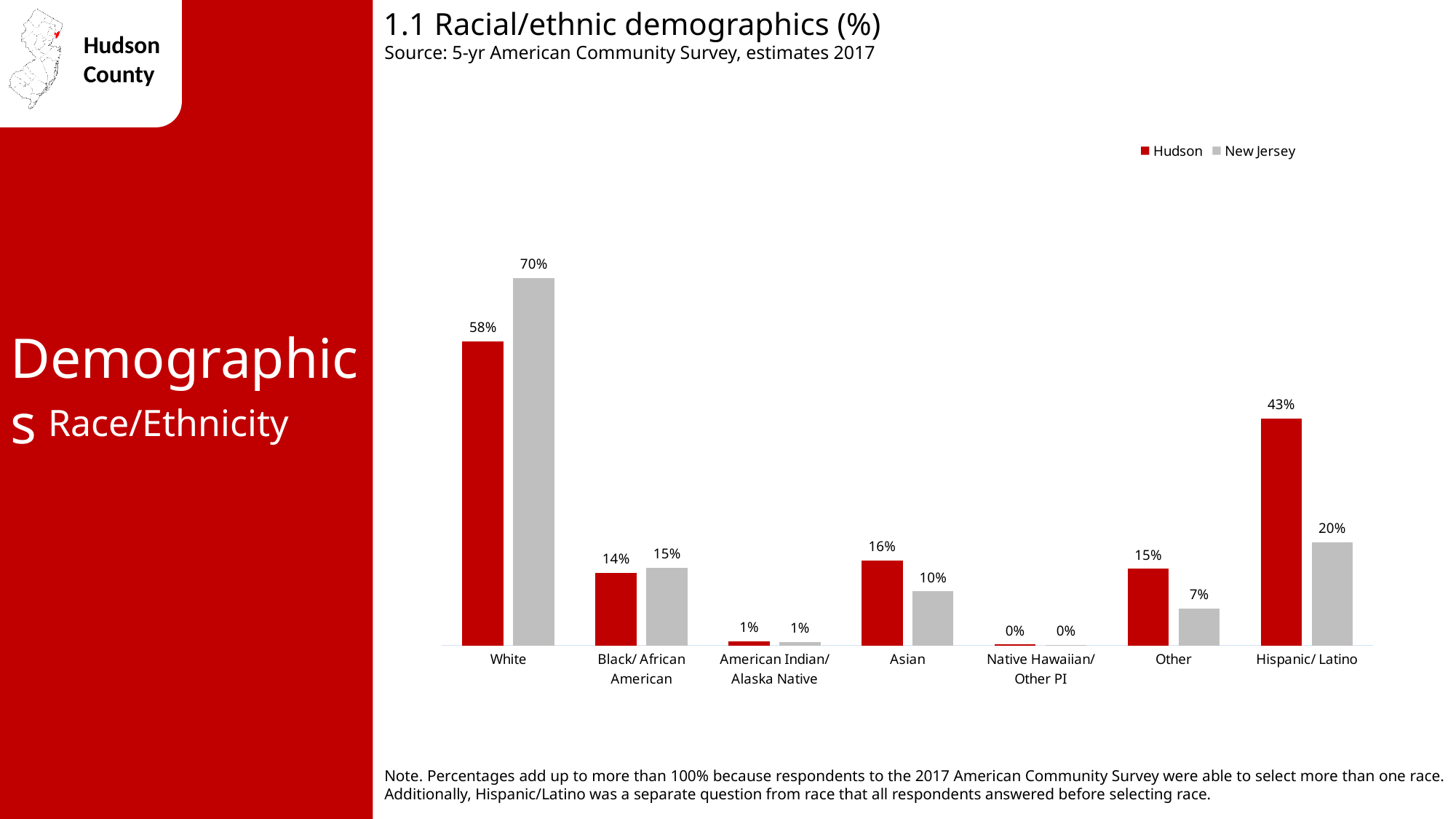
What is the difference between the New Jersey and Hudson values for White? 12% Which category has the highest Hudson value? White Which is larger for Other: the Hudson value or the New Jersey value? Hudson What is the Hudson value for White? 58% How many categories are shown on the x axis? 7 What is the difference between the Hudson and New Jersey values for Hispanic/ Latino? 23% Which is larger for Black/ African American: the Hudson value or the New Jersey value? New Jersey Which category has the highest New Jersey value? White What is the Hudson value for Asian? 16% How many series does the legend list? 2 What is the New Jersey value for Hispanic/ Latino? 20% What kind of chart is shown on the slide? Bar chart